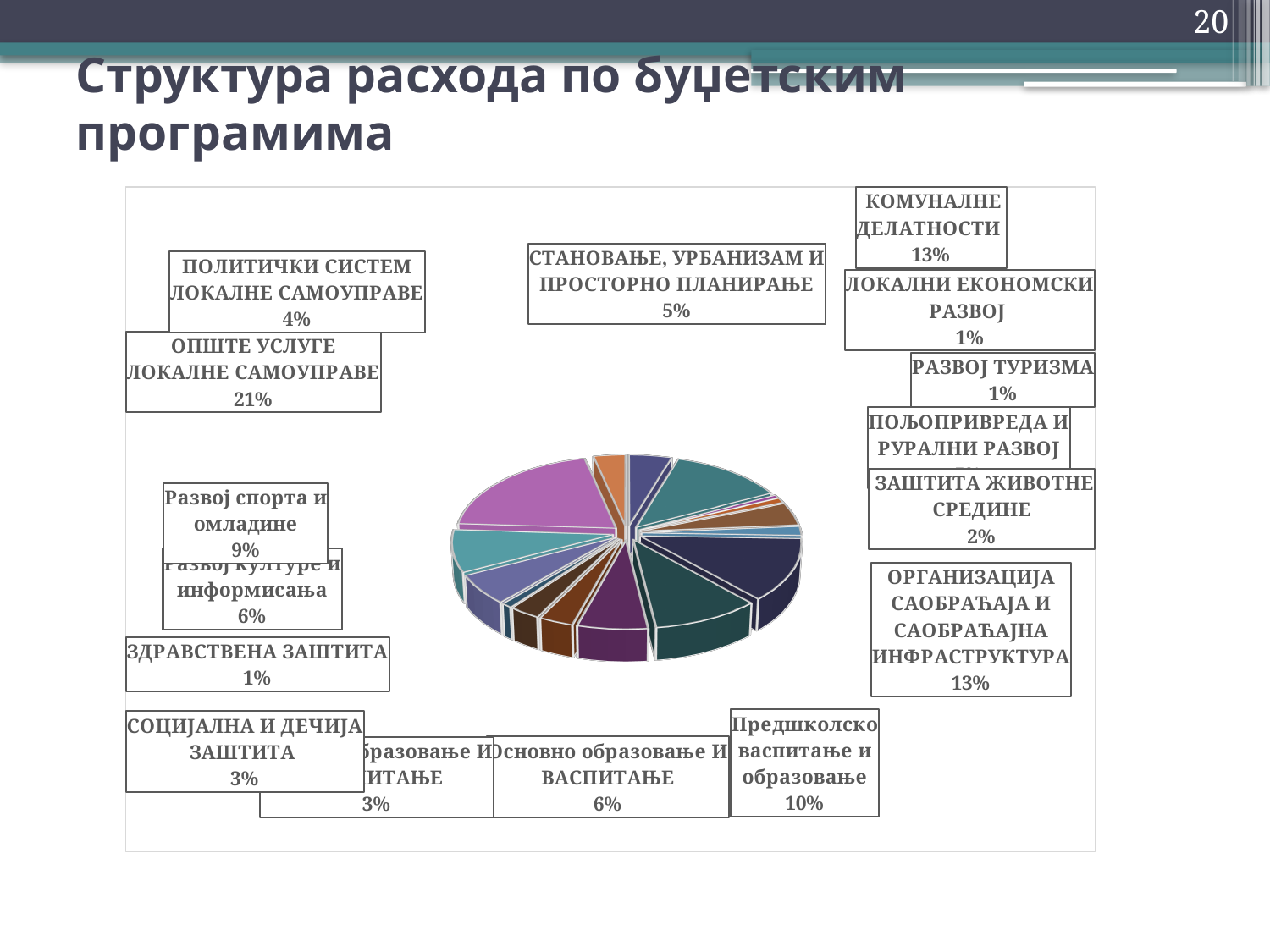
What percentage is shown for Развој спорта и омладине? 9% Which budget programme has the largest share of expenditure? ОПШТЕ УСЛУГЕ ЛОКАЛНЕ САМОУПРАВЕ Which has a larger share: СТАНОВАЊЕ, УРБАНИЗАМ И ПРОСТОРНО ПЛАНИРАЊЕ or ПОЛИТИЧКИ СИСТЕМ ЛОКАЛНЕ САМОУПРАВЕ? СТАНОВАЊЕ, УРБАНИЗАМ И ПРОСТОРНО ПЛАНИРАЊЕ What percentage is shown for Предшколско васпитање и образовање? 10% What percentage is shown for КОМУНАЛНЕ ДЕЛАТНОСТИ? 13% What percentage is shown for ЗАШТИТА ЖИВОТНЕ СРЕДИНЕ? 2% What share of expenditure goes to ОПШТЕ УСЛУГЕ ЛОКАЛНЕ САМОУПРАВЕ? 21% What percentage is shown for СОЦИЈАЛНА И ДЕЧИЈА ЗАШТИТА? 3% What is the title of the slide containing the chart? Структура расхода по буџетским програмима What is the difference in percentage points between ОПШТЕ УСЛУГЕ ЛОКАЛНЕ САМОУПРАВЕ and ОРГАНИЗАЦИЈА САОБРАЋАЈА И САОБРАЋАЈНА ИНФРАСТРУКТУРА? 8% Which has a larger share: Предшколско васпитање и образовање or Основно образовање И ВАСПИТАЊЕ? Предшколско васпитање и образовање What kind of chart is shown on the slide? pie chart